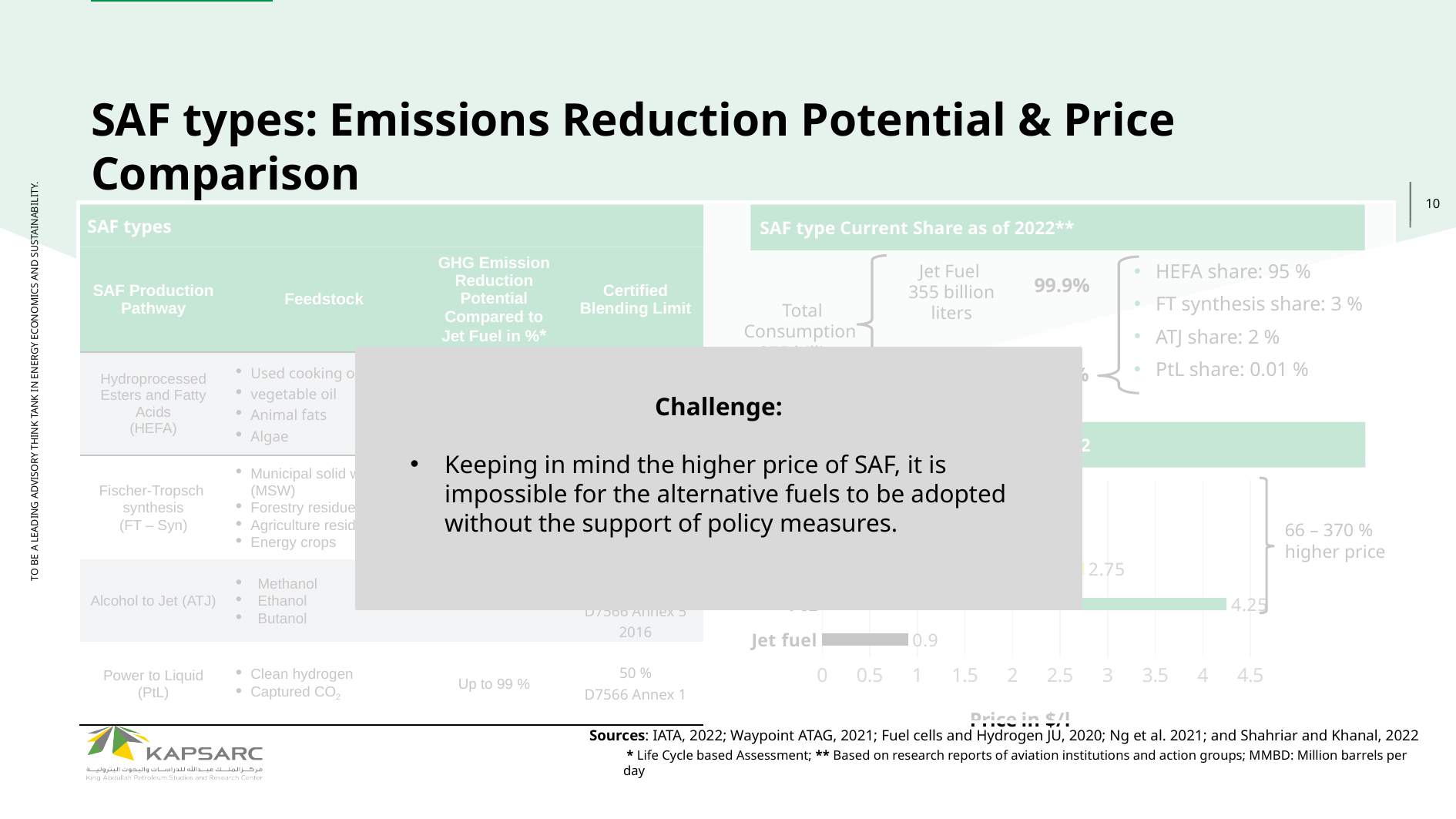
What kind of chart is used to show the price comparison on the slide? bar chart What range of higher price is annotated next to the bars in the price chart? 66 – 370 % higher price What is the price value shown for Jet fuel in the bar chart? 0.9 Is the value for Jet fuel in the price chart greater or less than 0.5? greater What is the highest tick value shown on the x axis of the price chart? 4.5 Is the value for Jet fuel in the price chart greater or less than 1? less What is the largest data label printed on the price bar chart? 4.25